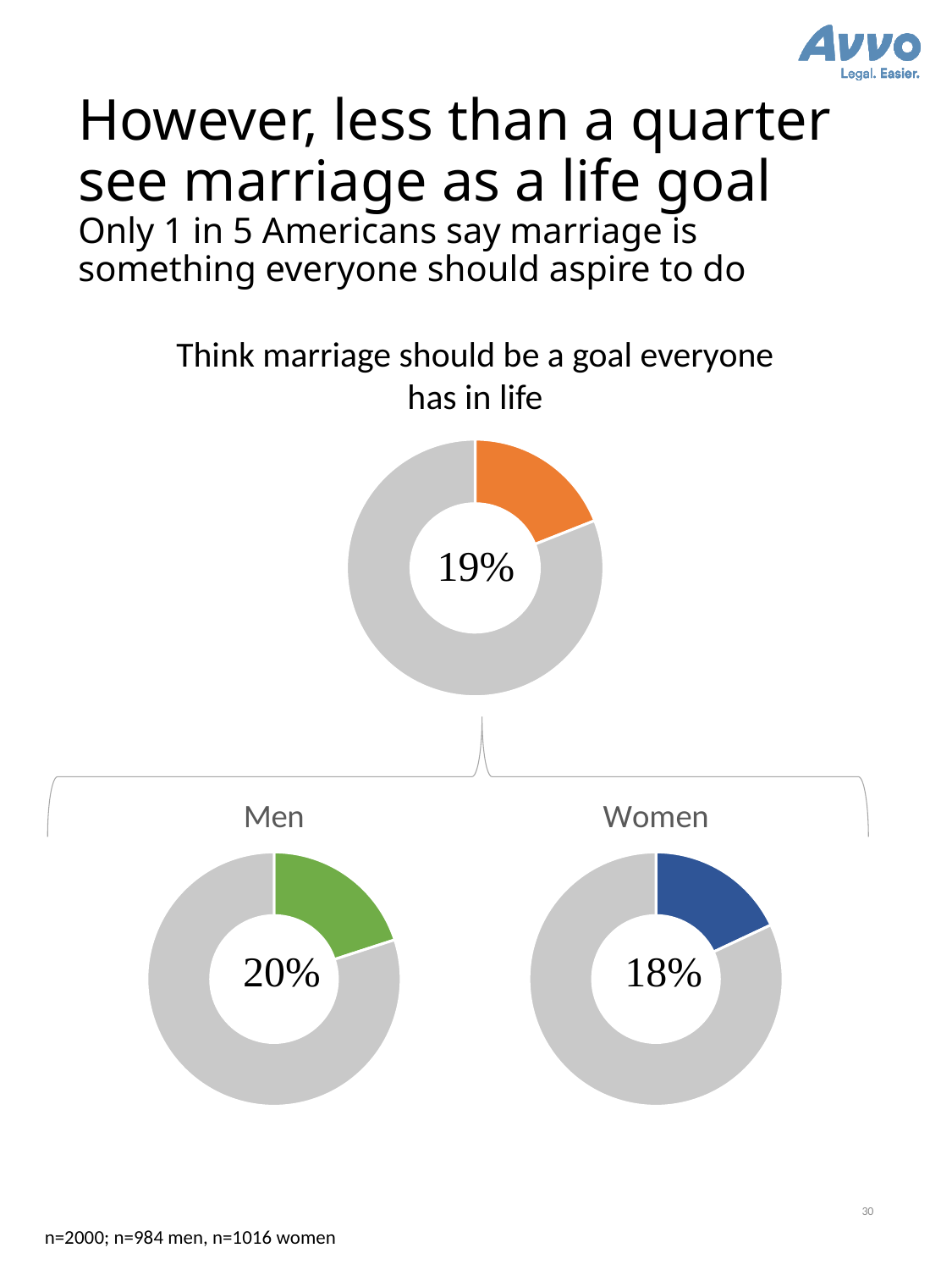
In the top chart, what share of the donut is coloured orange? 19% What colour is the highlighted segment in the 'Men' chart? Green In the 'Women' chart at the bottom right, what percentage is shown? 18% Comparing the 'Men' and 'Women' charts, which group has the higher percentage who think marriage should be a goal everyone has in life? Men What is the difference in percentage points between the 'Men' chart value and the 'Women' chart value? 2 What kind of chart is the top chart titled 'Think marriage should be a goal everyone has in life'? Donut chart In the 'Women' chart, what share of the donut is coloured blue? 18% How many donut charts are shown on the slide? 3 In the top chart titled 'Think marriage should be a goal everyone has in life', what percentage is shown in the centre of the donut? 19% What is the title of the top chart on the slide? Think marriage should be a goal everyone has in life Is the value shown in the top chart greater or less than 25%? less In the 'Men' chart at the bottom left, what percentage is shown? 20%